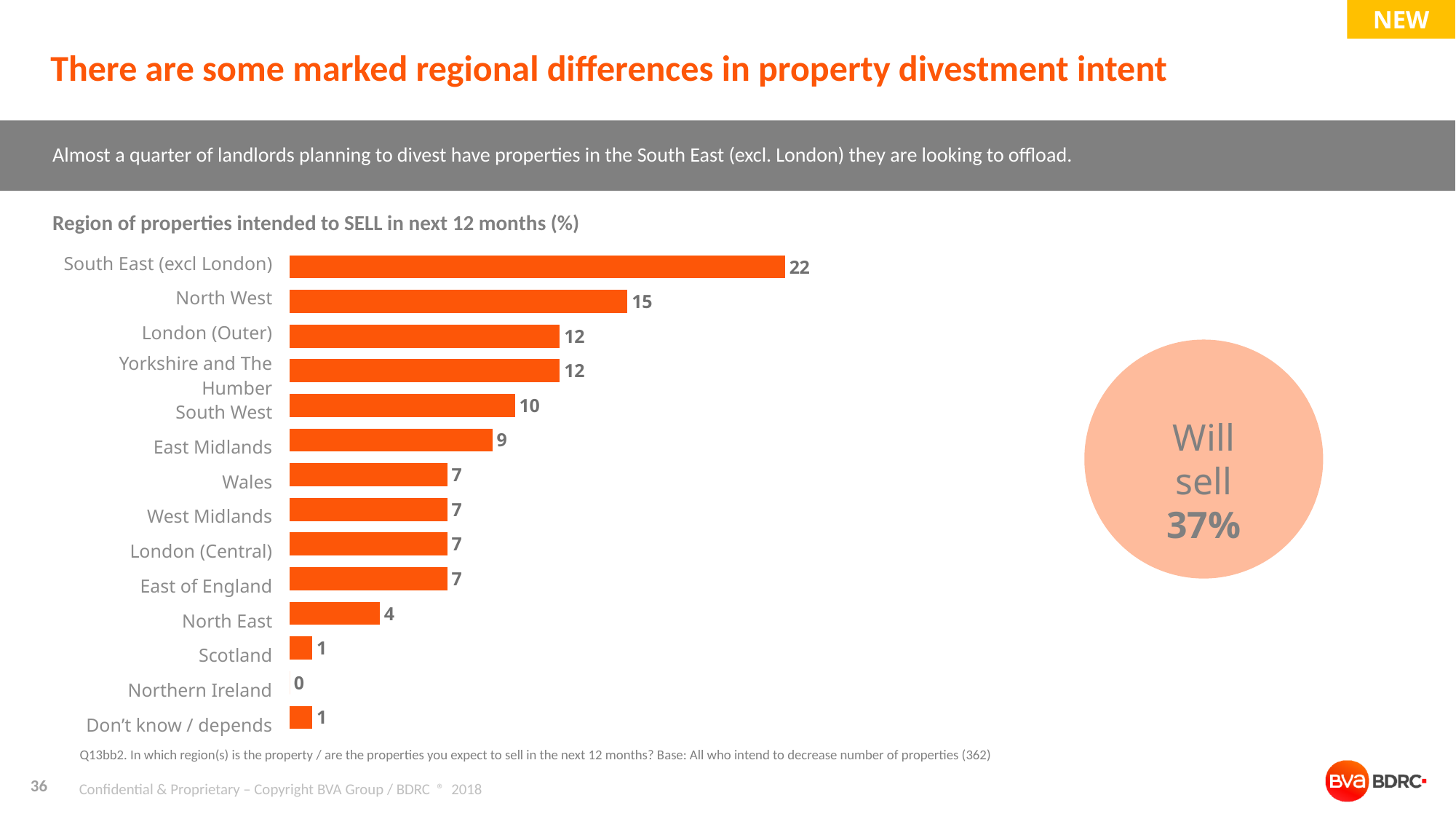
What is the value for South West? 10 What is the value for North West? 15 What is the value for North East? 4 Which region has the lowest value? Northern Ireland What is the title of the chart? Region of properties intended to SELL in next 12 months (%) Which is larger, the value for East Midlands or the value for Wales? East Midlands What percentage is shown in the circle labelled 'Will sell'? 37% What is the value for South East (excl London)? 22 What is the difference between the values for South East (excl London) and North West? 7 Which region has the highest value? South East (excl London) How many categories are shown in the bar chart? 14 What kind of chart is shown on the slide? Bar chart